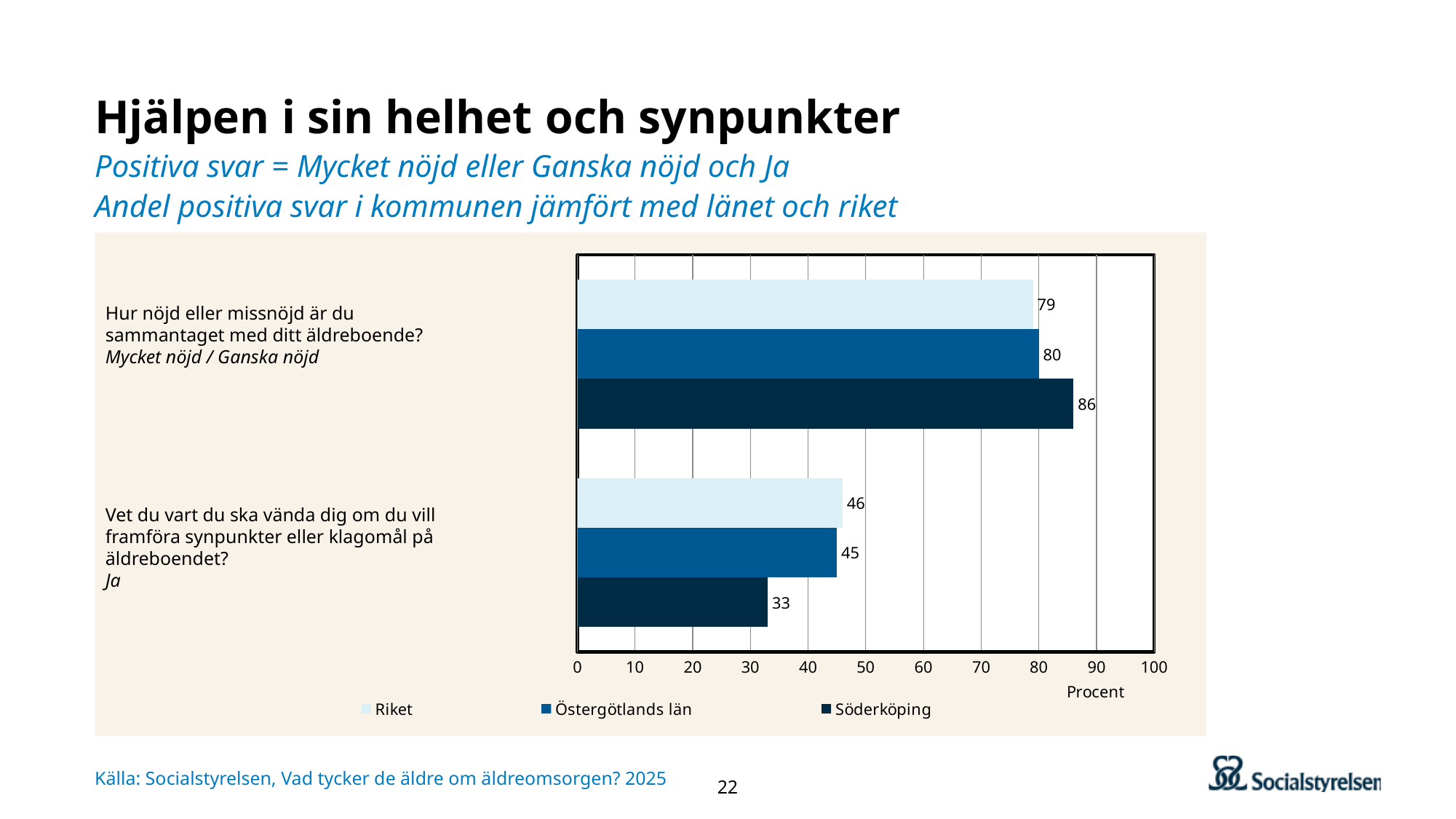
Which is larger for Söderköping: the value for 'Hur nöjd eller missnöjd är du sammantaget med ditt äldreboende?' or the value for 'Vet du vart du ska vända dig om du vill framföra synpunkter eller klagomål på äldreboendet?' Hur nöjd eller missnöjd är du sammantaget med ditt äldreboende? What is the value for Söderköping on the question 'Hur nöjd eller missnöjd är du sammantaget med ditt äldreboende?' 86 What is the difference between Riket and Söderköping on the question 'Vet du vart du ska vända dig om du vill framföra synpunkter eller klagomål på äldreboendet?' 13 What is the difference between Söderköping and Riket on the question 'Hur nöjd eller missnöjd är du sammantaget med ditt äldreboende?' 7 What is the label of the x axis? Procent How many series does the legend list? 3 Which series has the highest value on the question 'Hur nöjd eller missnöjd är du sammantaget med ditt äldreboende?' Söderköping What is the value for Östergötlands län on the question 'Hur nöjd eller missnöjd är du sammantaget med ditt äldreboende?' 80 Which series has the lowest value on the question 'Vet du vart du ska vända dig om du vill framföra synpunkter eller klagomål på äldreboendet?' Söderköping What kind of chart is shown on the slide? Bar chart Is the value for Söderköping on the question 'Vet du vart du ska vända dig om du vill framföra synpunkter eller klagomål på äldreboendet?' greater or less than 40? less What is the value for Riket on the question 'Vet du vart du ska vända dig om du vill framföra synpunkter eller klagomål på äldreboendet?' 46